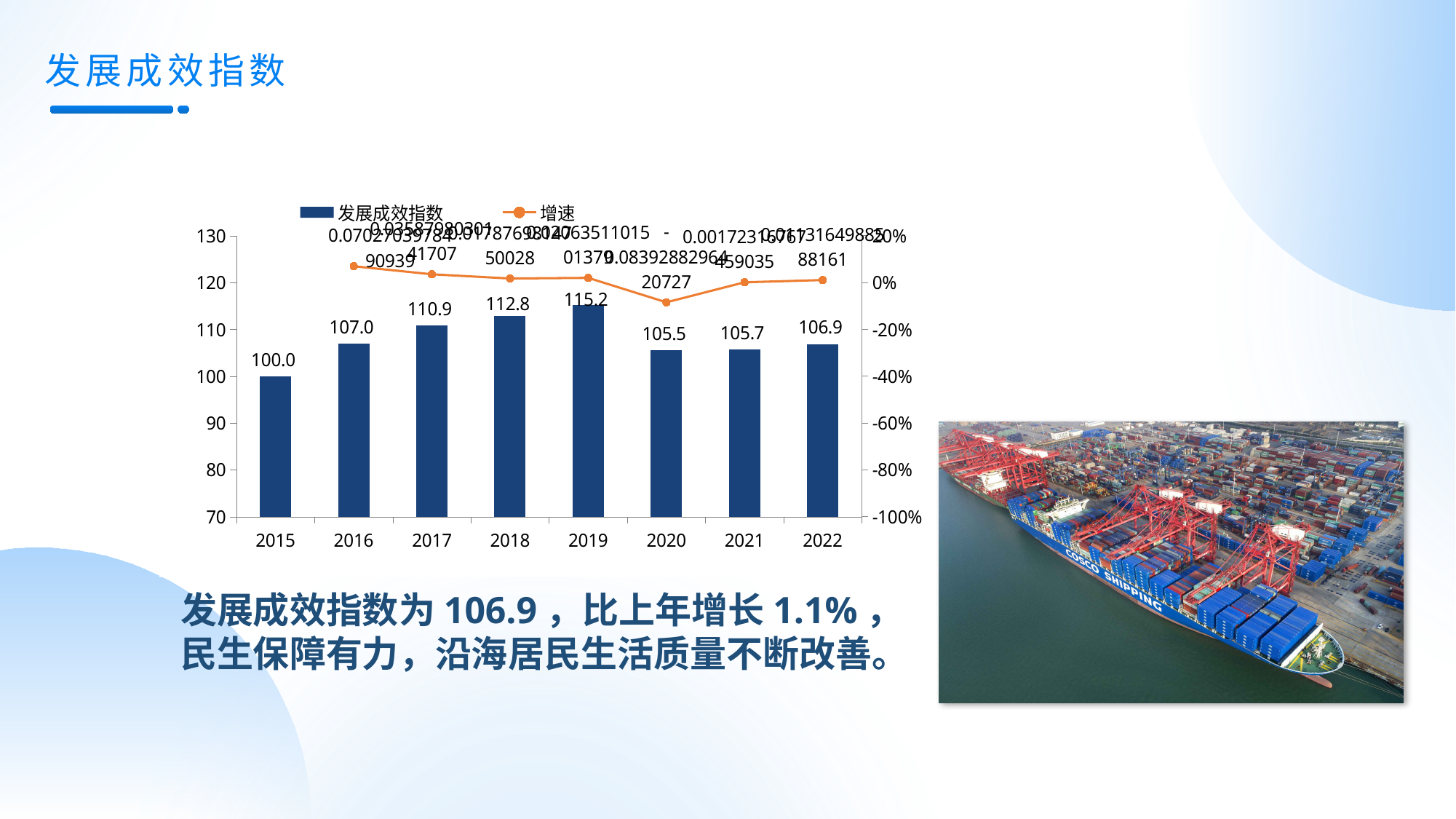
Which year has a larger 发展成效指数 value, 2017 or 2018? 2018 What is the difference between the 发展成效指数 values for 2022 and 2021? 1.2 What is the 发展成效指数 value for 2015? 100.0 Which year has the lowest 发展成效指数 bar? 2015 Which year has the highest 发展成效指数 bar? 2019 What is the 发展成效指数 value for 2019? 115.2 How many years are shown on the x axis of the chart? 8 What is the 发展成效指数 value for 2022? 106.9 What colour are the 发展成效指数 bars in the chart? dark blue Does the 发展成效指数 rise or fall from 2015 to 2019? rise How many series does the chart legend list? 2 What is the difference between the 发展成效指数 values for 2019 and 2020? 9.7